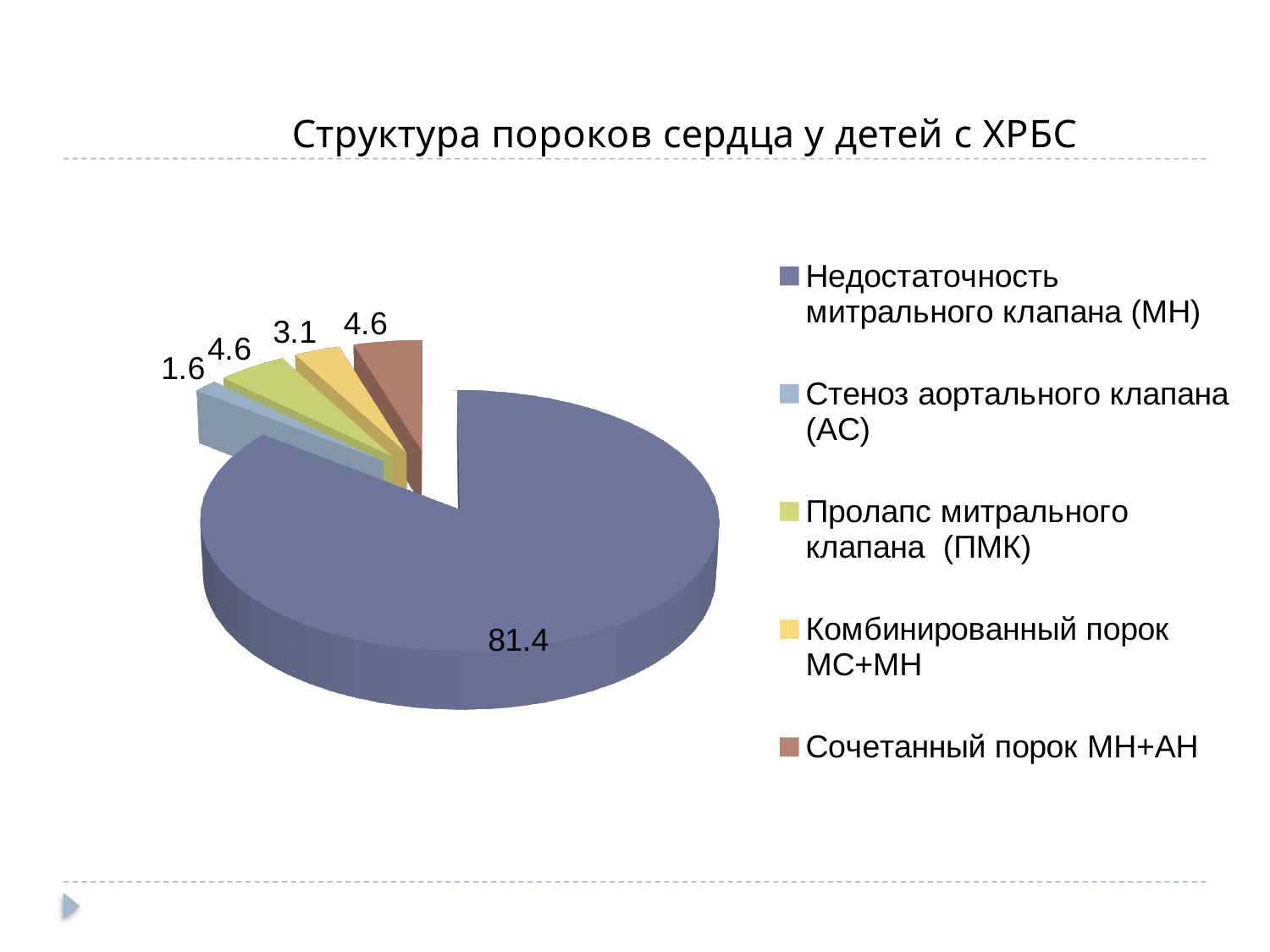
What is the value for Комбинированный порок МС+МН? 3.1 What is the value for Сочетанный порок МН+АН? 4.6 How many categories does the pie chart have? 5 What is the value for Недостаточность митрального клапана (МН)? 81.4 What is the value for Пролапс митрального клапана (ПМК)? 4.6 Which category has the largest slice of the pie? Недостаточность митрального клапана (МН) What is the title of the chart? Структура пороков сердца у детей с ХРБС Which category has the smallest slice of the pie? Стеноз аортального клапана (АС) Which is larger, the value for Комбинированный порок МС+МН or the value for Стеноз аортального клапана (АС)? Комбинированный порок МС+МН What is the difference between the values for Недостаточность митрального клапана (МН) and Пролапс митрального клапана (ПМК)? 76.8 What type of chart is shown on the slide? Pie chart What is the value for Стеноз аортального клапана (АС)? 1.6